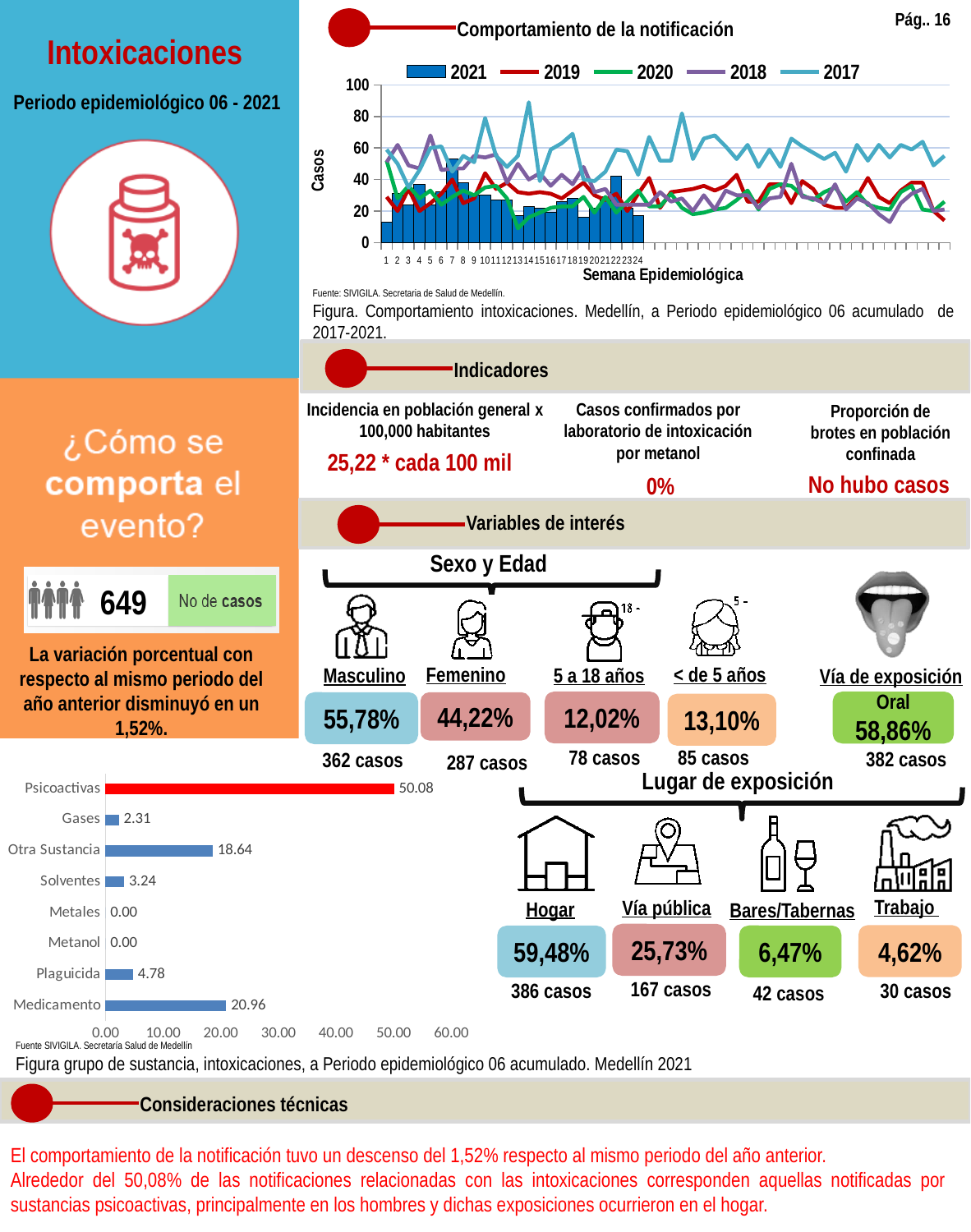
In the bottom-left bar chart (grupo de sustancia), what is the value for Psicoactivas? 50.08 In the top chart 'Comportamiento de la notificación', which series is drawn as bars rather than a line? 2021 In the bottom-left bar chart (grupo de sustancia), which categories have a value of 0.00? Metales and Metanol What kind of chart is the bottom-left chart (grupo de sustancia)? Bar chart In the bottom-left bar chart (grupo de sustancia), which category has the highest value? Psicoactivas In the bottom-left bar chart (grupo de sustancia), what is the difference between the values for Psicoactivas and Medicamento? 29.12 In the bottom-left bar chart (grupo de sustancia), what is the value for Medicamento? 20.96 In the bottom-left bar chart (grupo de sustancia), which is larger, Medicamento or Otra Sustancia? Medicamento In the bottom-left bar chart (grupo de sustancia), what is the value for Plaguicida? 4.78 In the top chart 'Comportamiento de la notificación', how many series does the legend list? 5 In the bottom-left bar chart (grupo de sustancia), how many categories are shown? 8 In the top chart 'Comportamiento de la notificación', is the value for 2017 at week 14 greater or less than 80? greater